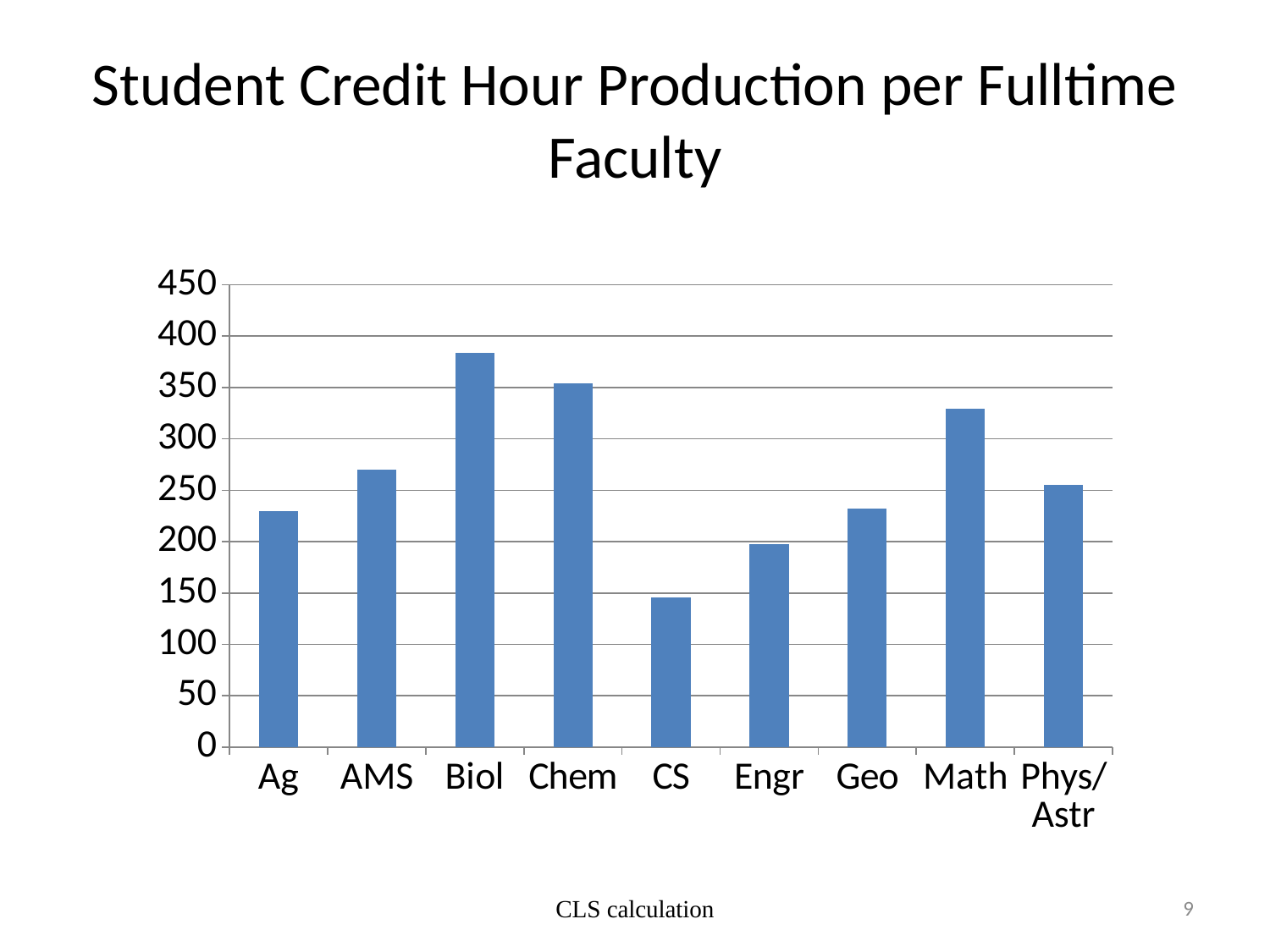
Is the value for Biol greater or less than 350? greater Which has a larger value, Engr or Phys/Astr? Phys/Astr Which category has the lowest value in the chart? CS Is the value for Math greater or less than 300? greater How many categories are shown on the x axis of the chart? 9 What kind of chart is shown on the slide? bar chart Which has a larger value, Math or AMS? Math Which has a larger value, Biol or Chem? Biol What is the title of the slide containing the chart? Student Credit Hour Production per Fulltime Faculty Is the value for CS greater or less than 150? less Which category has the highest value in the chart? Biol